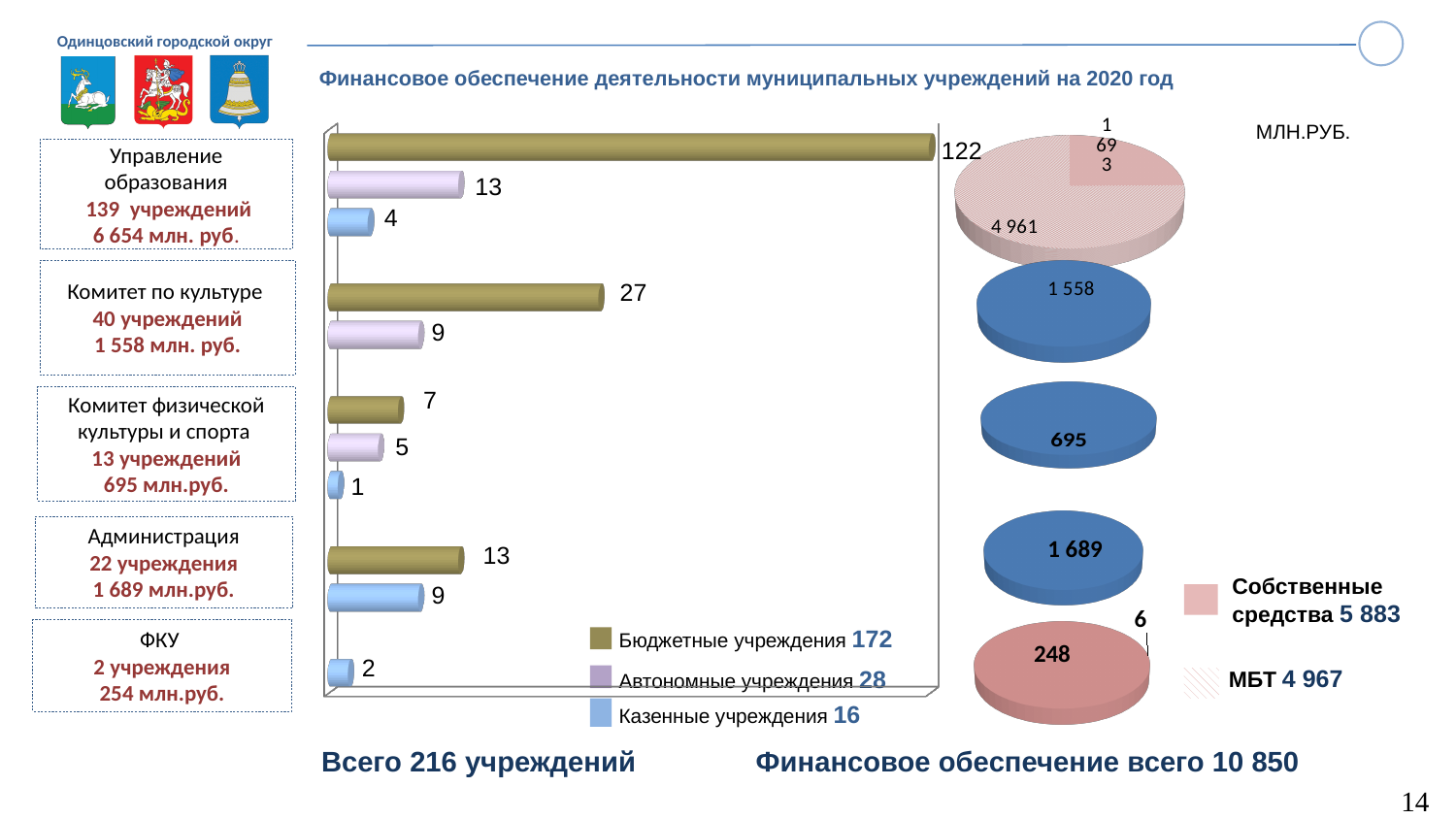
In the bar chart, what is the value of the Бюджетные учреждения bar in the second group (Комитет по культуре)? 27 In the bar chart, what is the value of the Казенные учреждения bar in the top group (Управление образования)? 4 In the bar chart, what is the value of the longest bar (Бюджетные учреждения for Управление образования)? 122 In the bar chart, what is the value of the smallest bar (Казенные учреждения in the Комитет физической культуры и спорта group)? 1 In the bottom pie chart (ФКУ), what is the total of the two slices 248 and 6? 254 What value is shown on the pie chart labelled for Комитет физической культуры и спорта (third pie from the top)? 695 In the bar chart, what is the difference between the Бюджетные учреждения bar (27) and the Автономные учреждения bar (9) in the second group (Комитет по культуре)? 18 According to the bar chart legend, how many Бюджетные учреждения are there in total? 172 In the bar chart, which is larger in the fourth group (Администрация): the Бюджетные учреждения bar or the Казенные учреждения bar? Бюджетные учреждения In the bar chart, how many series does the legend list? 3 In the bar chart, what is the value of the Автономные учреждения bar in the top group (Управление образования)? 13 What type of chart is the large chart on the left side of the slide? bar chart